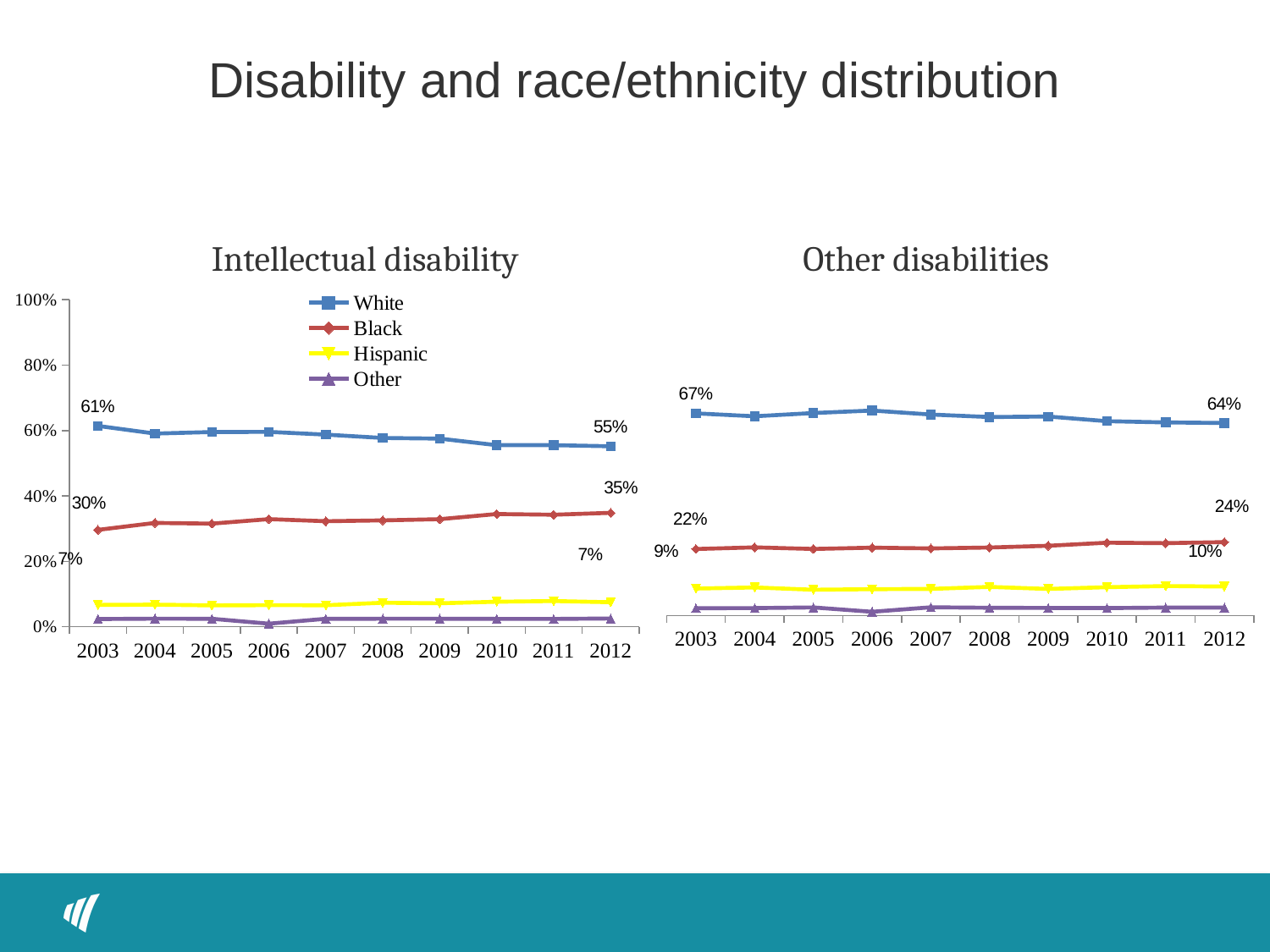
In the Intellectual disability chart, does the White series rise or fall from 2003 to 2012? fall In the Intellectual disability chart, by how many percentage points did the White value fall from 2003 to 2012? 6 percentage points How many series does the legend of the Intellectual disability chart list? 4 How many years are shown on the x axis of the Intellectual disability chart? 10 In the Intellectual disability chart, is the value for Other in 2012 greater or less than 20%? less In the Intellectual disability chart, which series has the highest values across all years? White In the Other disabilities chart, what is the value for the White series in 2003? 67% In the Intellectual disability chart, by how many percentage points did the Black value rise from 2003 to 2012? 5 percentage points In the Intellectual disability chart, what is the value for White in 2003? 61% In the Other disabilities chart, what is the value for the Black series in 2012? 24% In the Intellectual disability chart, what is the value for Black in 2012? 35% In the Other disabilities chart, which is larger in 2012, the White value or the Black value? White